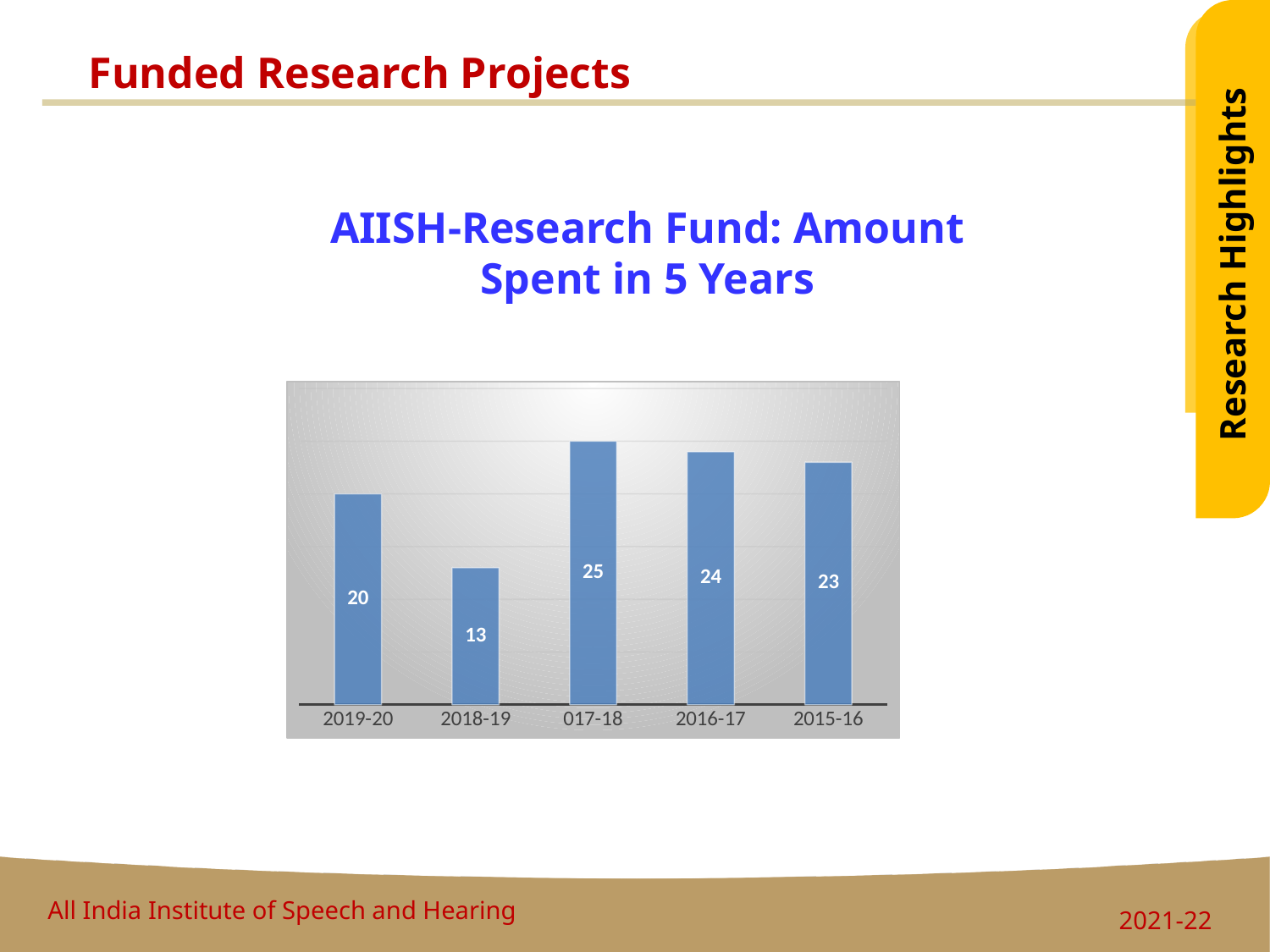
What kind of chart is shown on the slide? bar chart What is the title of the chart? AIISH-Research Fund: Amount Spent in 5 Years What is the value for 2016-17? 24 How many categories are shown on the x axis? 5 What is the value for 2018-19? 13 What is the difference between the values for 017-18 and 2018-19? 12 Which is larger, the value for 2019-20 or the value for 2015-16? 2015-16 What is the difference between the values for 2016-17 and 2015-16? 1 Which category has the lowest value? 2018-19 What is the value for 2015-16? 23 Which category has the highest value? 017-18 What is the value for 2019-20? 20